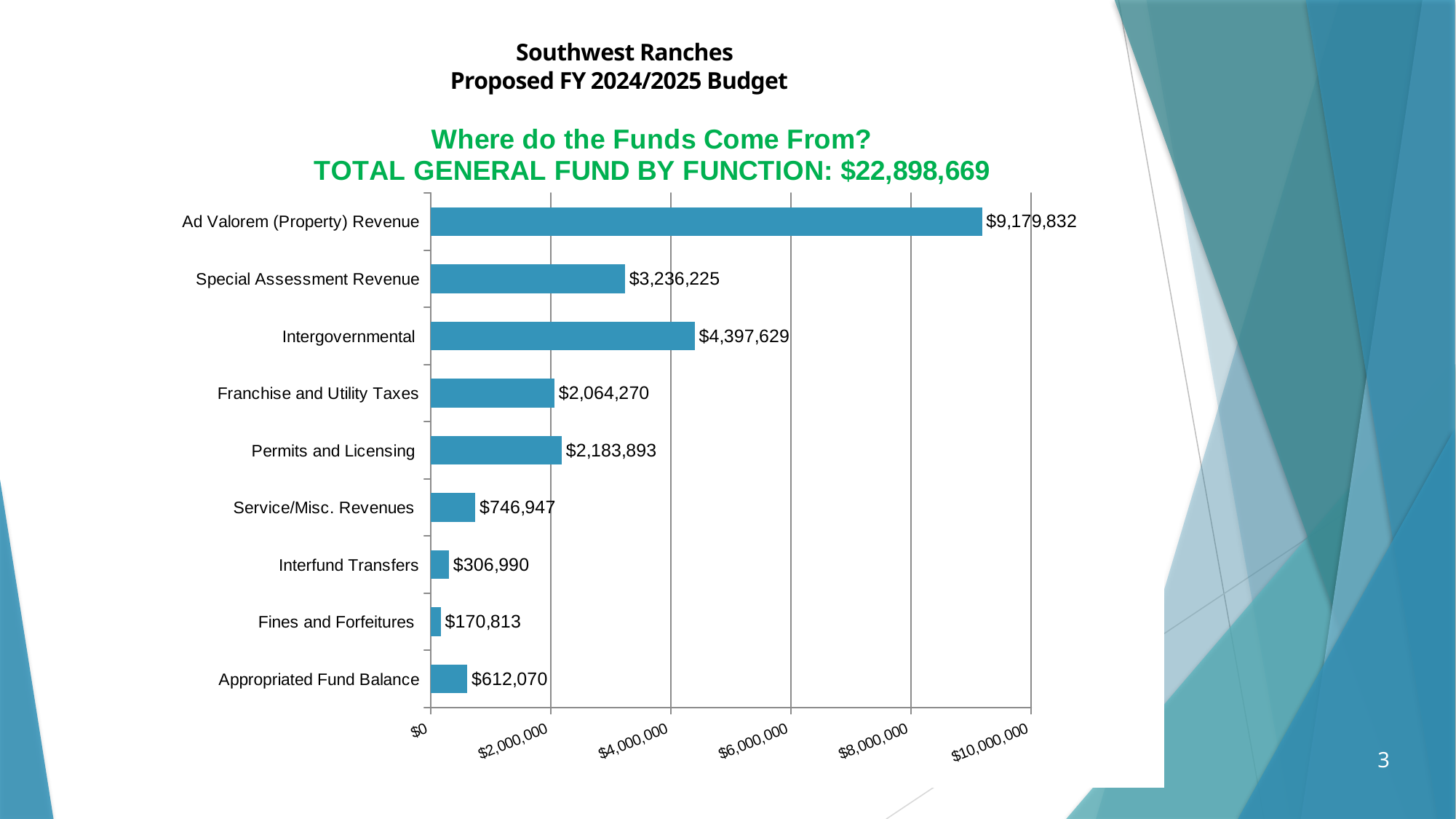
Which category has the lowest value? Fines and Forfeitures Which is larger, Permits and Licensing or Franchise and Utility Taxes? Permits and Licensing What is the difference between Intergovernmental and Special Assessment Revenue? $1,161,404 What is the value for Appropriated Fund Balance? $612,070 How many categories are shown in the chart? 9 Which category has the highest value? Ad Valorem (Property) Revenue Is the value for Special Assessment Revenue greater or less than $4,000,000? less What is the value for Ad Valorem (Property) Revenue? $9,179,832 What total general fund amount is stated in the chart title? $22,898,669 What kind of chart is shown on the slide? bar chart What is the value for Intergovernmental? $4,397,629 What is the value for Fines and Forfeitures? $170,813